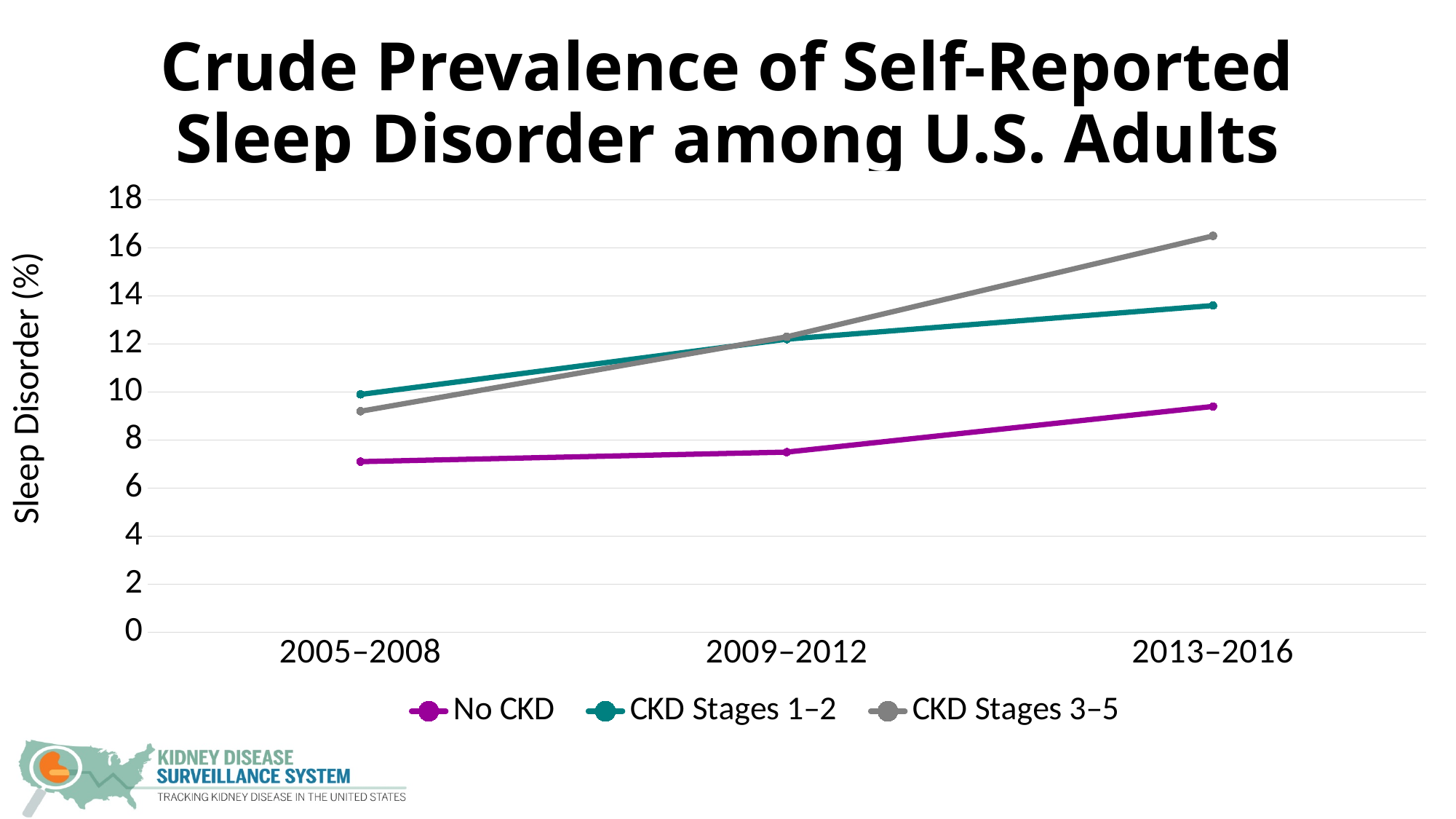
Which series has the highest value in 2013–2016? CKD Stages 3–5 Is the value for No CKD in 2005–2008 greater or less than 8? less Does the No CKD series rise or fall from 2005–2008 to 2013–2016? rise How many series does the legend list? 3 Is the value for No CKD in 2013–2016 greater or less than 10? less Which series has the lowest value in 2013–2016? No CKD What is the label of the y axis? Sleep Disorder (%) In 2013–2016, which is larger: CKD Stages 1–2 or CKD Stages 3–5? CKD Stages 3–5 Which series has the lowest value in 2005–2008? No CKD What kind of chart is shown on the slide? line chart Is the value for CKD Stages 3–5 in 2013–2016 greater or less than 14? greater How many time periods are shown on the x axis? 3